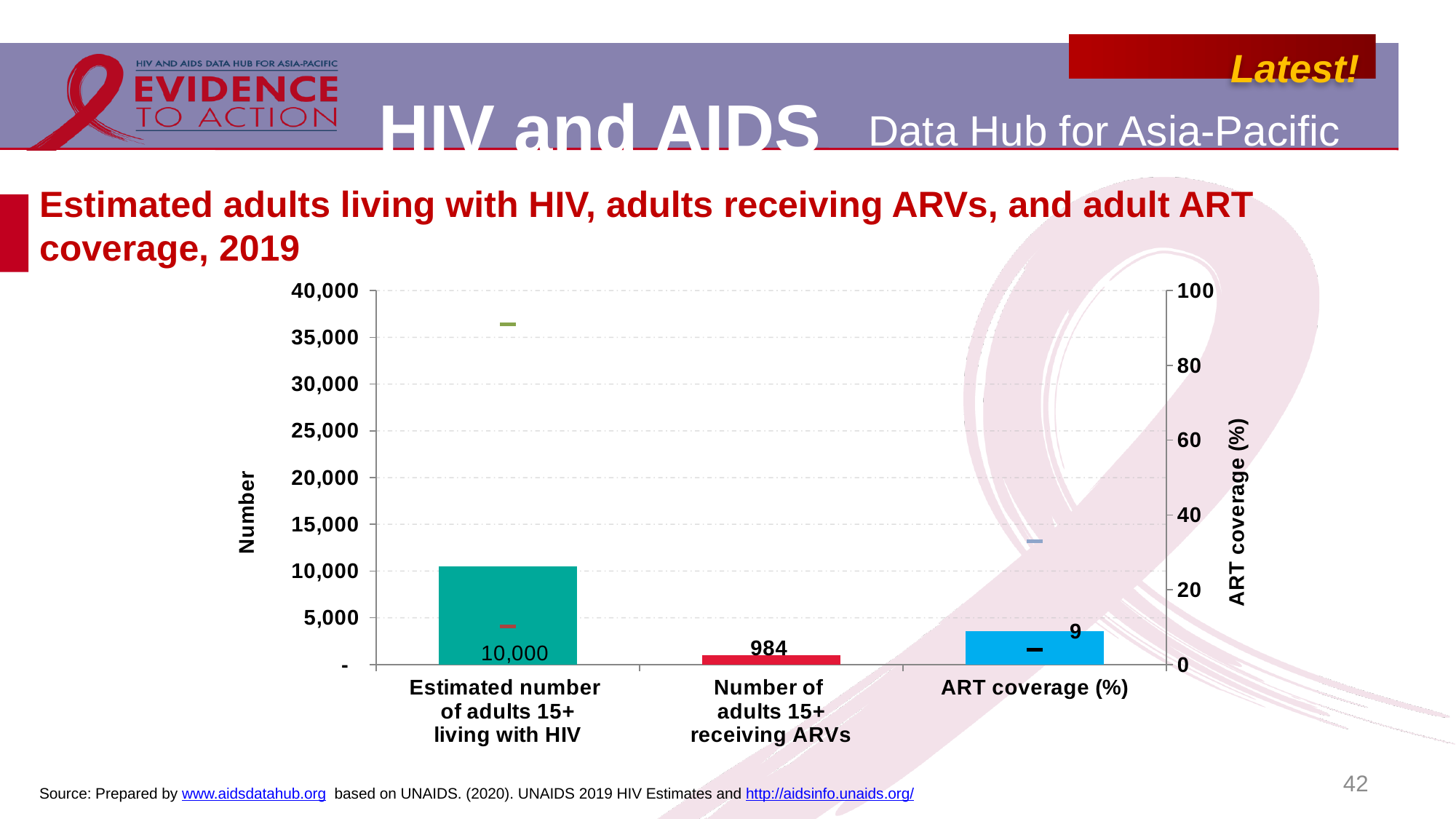
What is the difference between the estimated number of adults 15+ living with HIV and the number of adults 15+ receiving ARVs? 9,016 What is the ART coverage (%) value shown on the chart? 9 Is the ART coverage (%) value greater or less than 20 on the right-hand axis? less What is the number of adults 15+ receiving ARVs shown on the chart? 984 Which is larger: the estimated number of adults 15+ living with HIV or the number of adults 15+ receiving ARVs? Estimated number of adults 15+ living with HIV Is the value for the estimated number of adults 15+ living with HIV greater or less than 5,000? greater What is the estimated number of adults 15+ living with HIV shown on the chart? 10,000 Which category has the tallest bar on the chart? Estimated number of adults 15+ living with HIV What kind of chart is shown on the slide? Bar chart How many categories are shown on the x axis of the chart? 3 What is the title of the left vertical axis? Number What is the title of the right vertical axis? ART coverage (%)